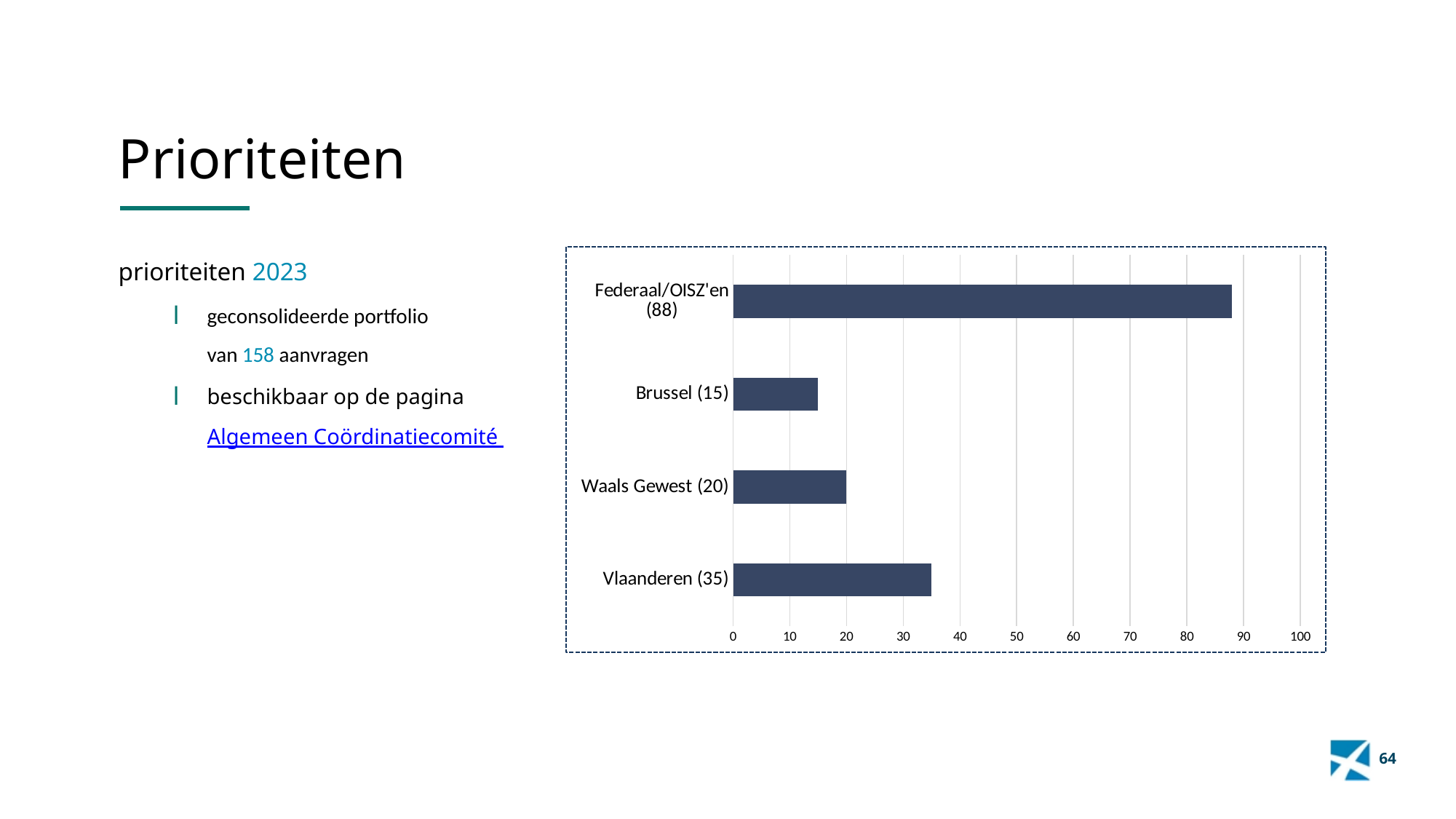
What is the difference between the values for Federaal/OISZ'en and Vlaanderen? 53 What is the value for Brussel? 15 What is the value for Federaal/OISZ'en? 88 What is the highest value shown on the horizontal axis of the chart? 100 Which category has the lowest value? Brussel Which category has the highest value? Federaal/OISZ'en How many categories does the bar chart show? 4 Which is larger, the value for Waals Gewest or the value for Brussel? Waals Gewest Is the value for Vlaanderen greater or less than 30? greater What kind of chart is shown on the slide? bar chart What is the value for Vlaanderen? 35 What is the value for Waals Gewest? 20